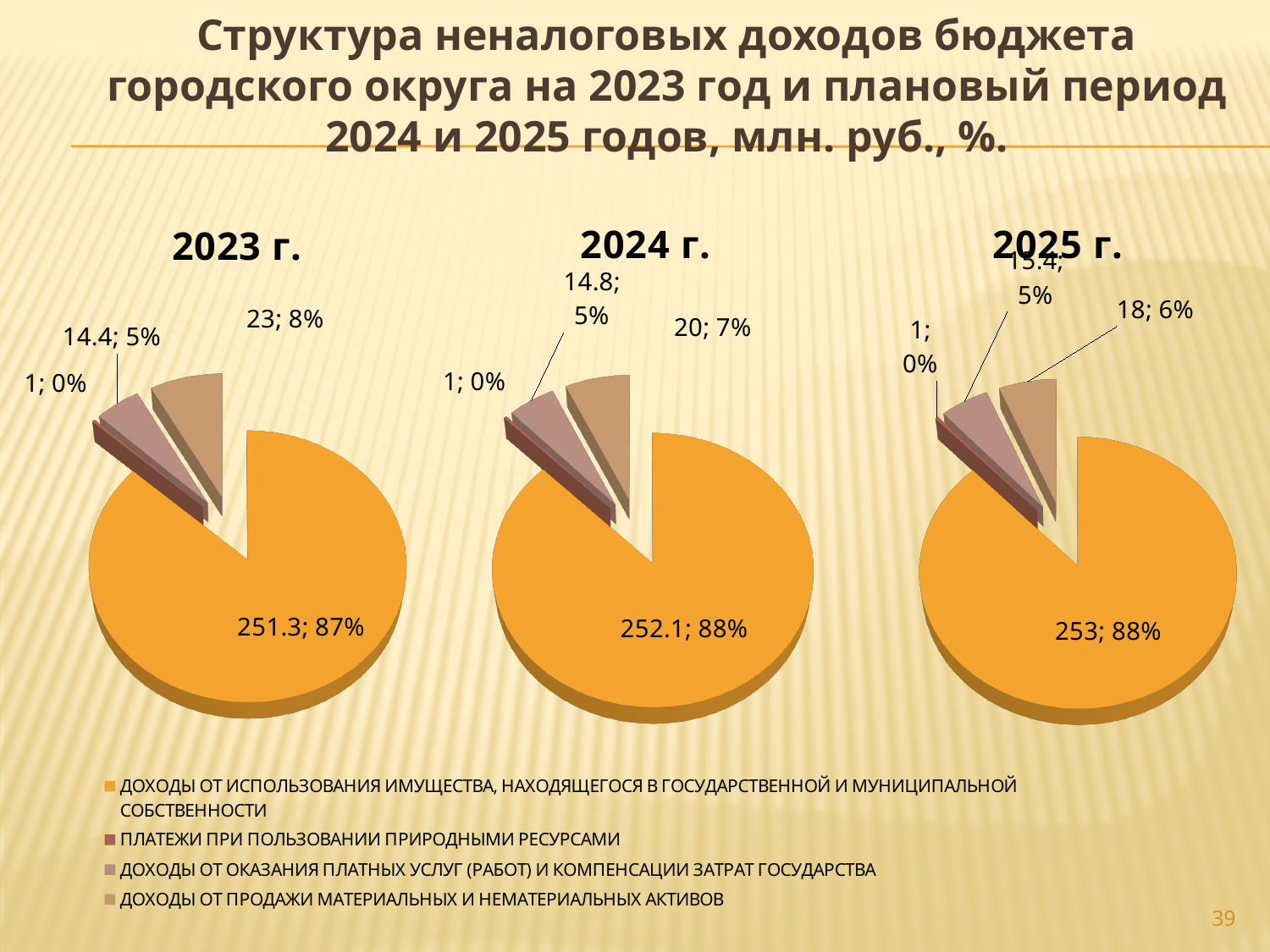
What is the difference between the value for доходы от продажи материальных и нематериальных активов in the 2023 г. chart and in the 2025 г. chart? 5 How many entries does the legend list? 4 In the 2025 г. pie chart, what value and share are shown for доходы от продажи материальных и нематериальных активов? 18; 6% In the 2023 г. pie chart, what value and share are shown for доходы от оказания платных услуг (работ) и компенсации затрат государства? 14.4; 5% In the 2023 г. pie chart, what value and share are shown for доходы от продажи материальных и нематериальных активов? 23; 8% In the 2024 г. pie chart, which category has the smallest slice? Платежи при пользовании природными ресурсами In the 2024 г. pie chart, what value and share are shown for доходы от продажи материальных и нематериальных активов? 20; 7% In the 2025 г. pie chart, what share of the pie is доходы от использования имущества, находящегося в государственной и муниципальной собственности? 88% In the 2024 г. pie chart, what value and share are shown for доходы от использования имущества, находящегося в государственной и муниципальной собственности? 252.1; 88% What kind of charts are shown on the slide? Pie charts How many pie charts are on the slide? 3 In the 2023 г. pie chart, what value and share are shown for доходы от использования имущества, находящегося в государственной и муниципальной собственности? 251.3; 87%